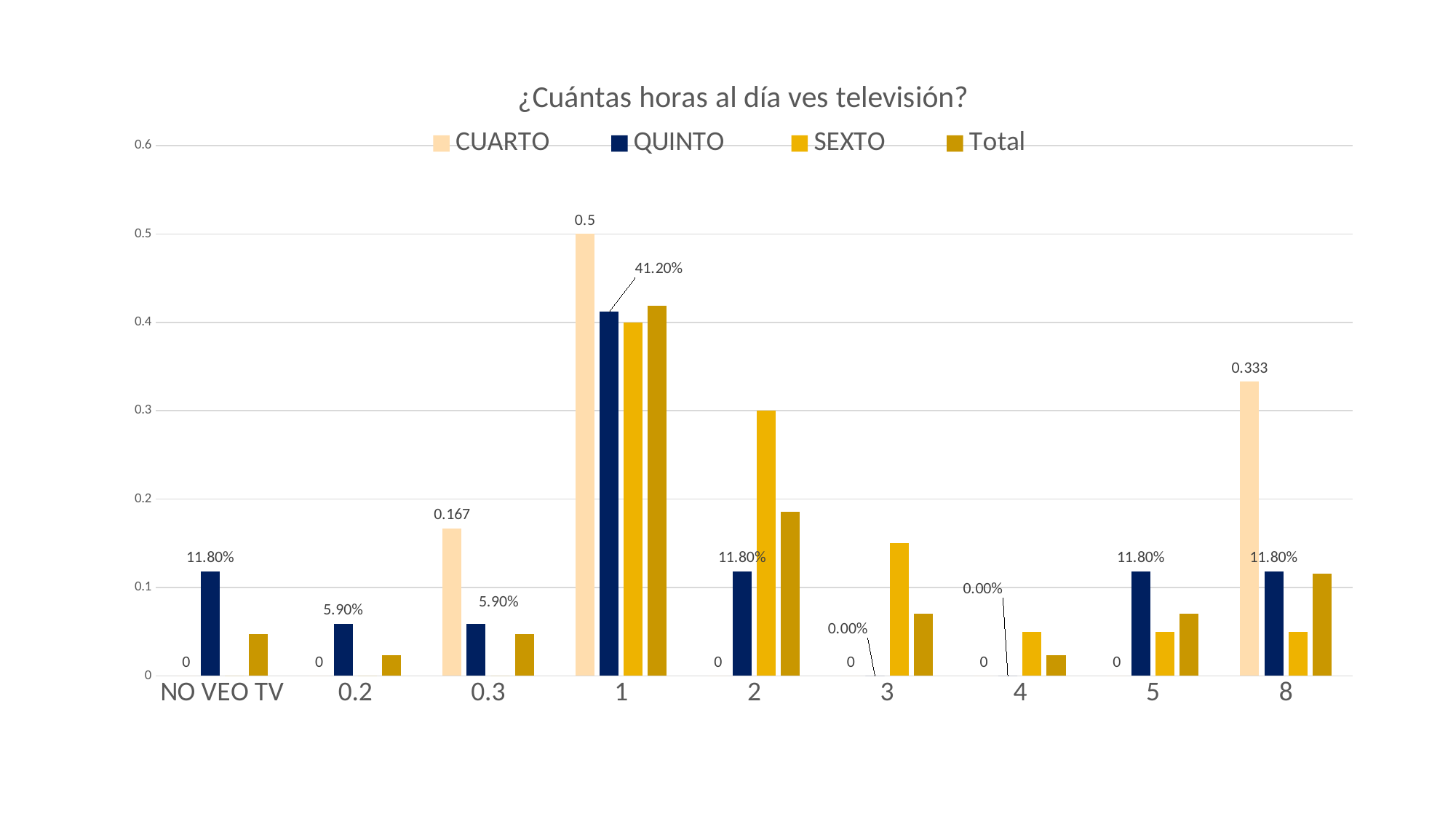
Which category has the larger CUARTO value, 0.3 or 8? 8 Is the SEXTO value for category 2 greater or less than 0.2? greater How many series does the legend list? 4 What is the CUARTO value for the category 1? 0.5 What is the CUARTO value for the category 8? 0.333 What is the difference between the CUARTO values for categories 1 and 8? 0.167 Which category has the highest CUARTO value? 1 What is the QUINTO value for the category 1? 41.20% What kind of chart is shown on the slide? bar chart How many categories are shown on the x axis? 9 Which category has the highest QUINTO value? 1 What is the QUINTO value for the category 0.2? 5.90%